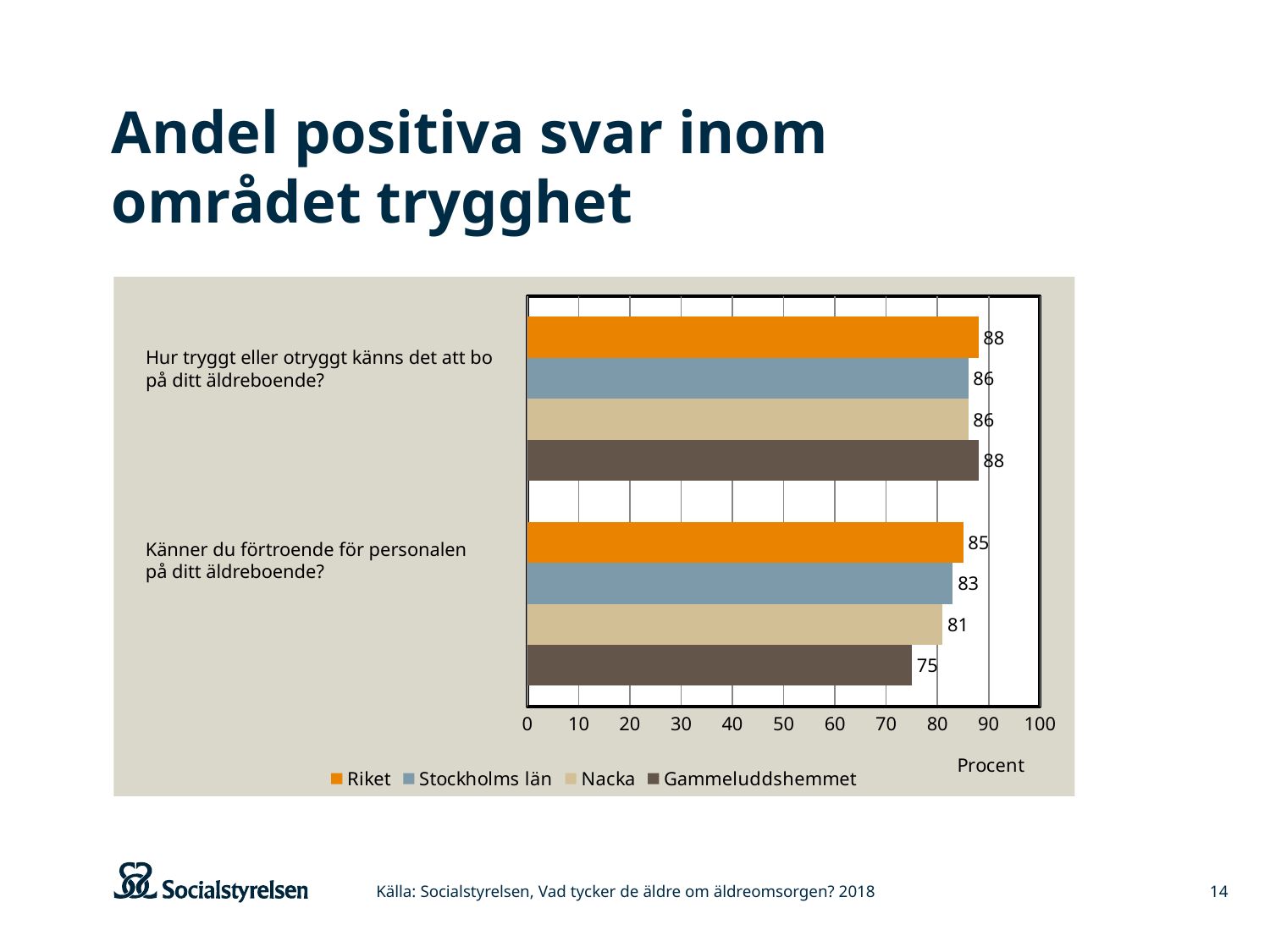
How many questions (categories) are shown on the chart? 2 What is the value for Gammeluddshemmet on the question "Känner du förtroende för personalen på ditt äldreboende?"? 75 What is the difference between Riket and Gammeluddshemmet on the question "Känner du förtroende för personalen på ditt äldreboende?"? 10 What unit is shown on the horizontal axis of the chart? Procent Which is larger for Gammeluddshemmet: the value for "Hur tryggt eller otryggt känns det att bo på ditt äldreboende?" or for "Känner du förtroende för personalen på ditt äldreboende?"? Hur tryggt eller otryggt känns det att bo på ditt äldreboende? What kind of chart is shown on the slide? Bar chart What is the value for Nacka on the question "Känner du förtroende för personalen på ditt äldreboende?"? 81 Which series has the highest value on the question "Känner du förtroende för personalen på ditt äldreboende?"? Riket How many series does the legend list? 4 What is the value for Riket on the question "Hur tryggt eller otryggt känns det att bo på ditt äldreboende?"? 88 What is the value for Stockholms län on the question "Hur tryggt eller otryggt känns det att bo på ditt äldreboende?"? 86 Which series has the lowest value on the question "Känner du förtroende för personalen på ditt äldreboende?"? Gammeluddshemmet